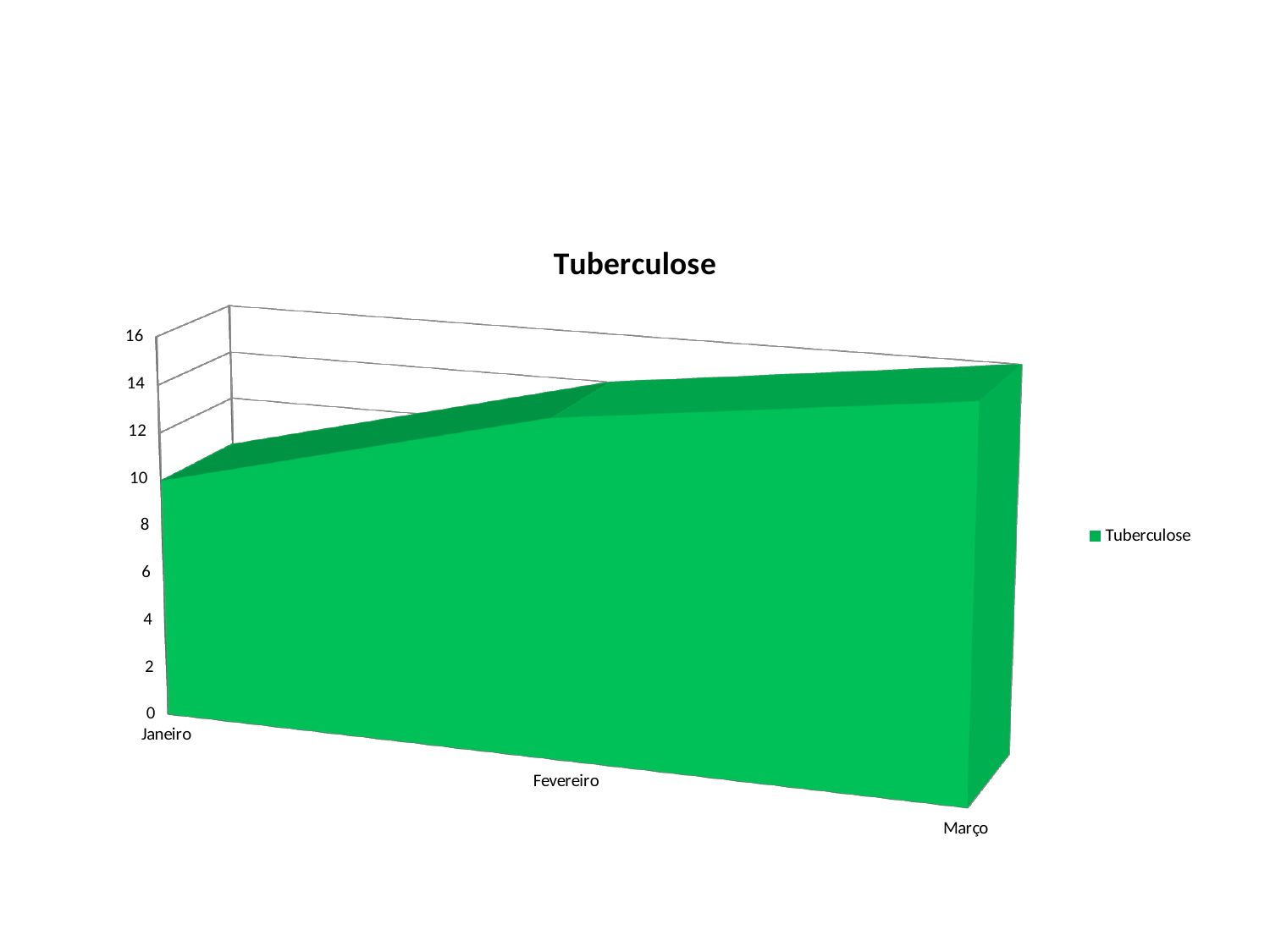
Which is larger, the value for Janeiro or the value for Março? Março Which is larger, the value for Janeiro or the value for Fevereiro? Fevereiro Is the value for Fevereiro greater or less than 12? greater How many series does the legend list? 1 How many categories are shown on the x axis of the chart? 3 Is the value for Janeiro greater or less than 12? less Do the values rise or fall from Janeiro to Março? Rise What is the title of the chart? Tuberculose What is the name of the series shown in the legend? Tuberculose Is the value for Março greater or less than 12? greater Which month has the lowest value in the chart? Janeiro What kind of chart is shown on the slide? Area chart